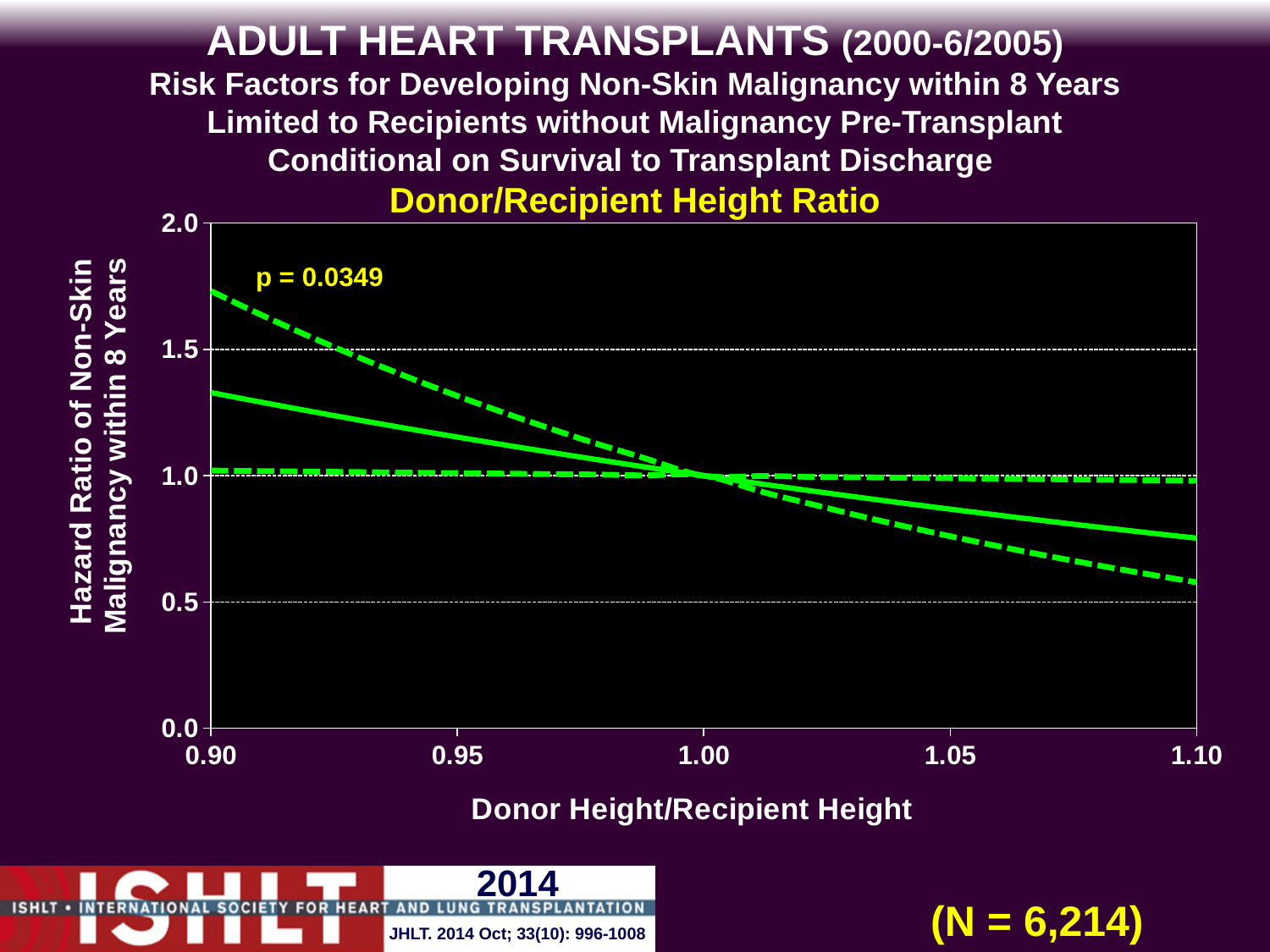
Does the solid hazard ratio line rise or fall as the donor height/recipient height ratio increases from 0.90 to 1.10? fall Is the solid hazard ratio line at a height ratio of 0.90 greater or less than 1.0? greater What is the p-value printed on the chart? p = 0.0349 How many lines are plotted on the chart? 3 What is the highest value shown on the y axis? 2.0 What kind of chart is shown on the slide? line chart Is the solid hazard ratio line at a height ratio of 0.90 greater or less than 1.5? less Is the upper dashed line at a height ratio of 0.90 greater or less than 1.5? greater What is the label of the x axis? Donor Height/Recipient Height